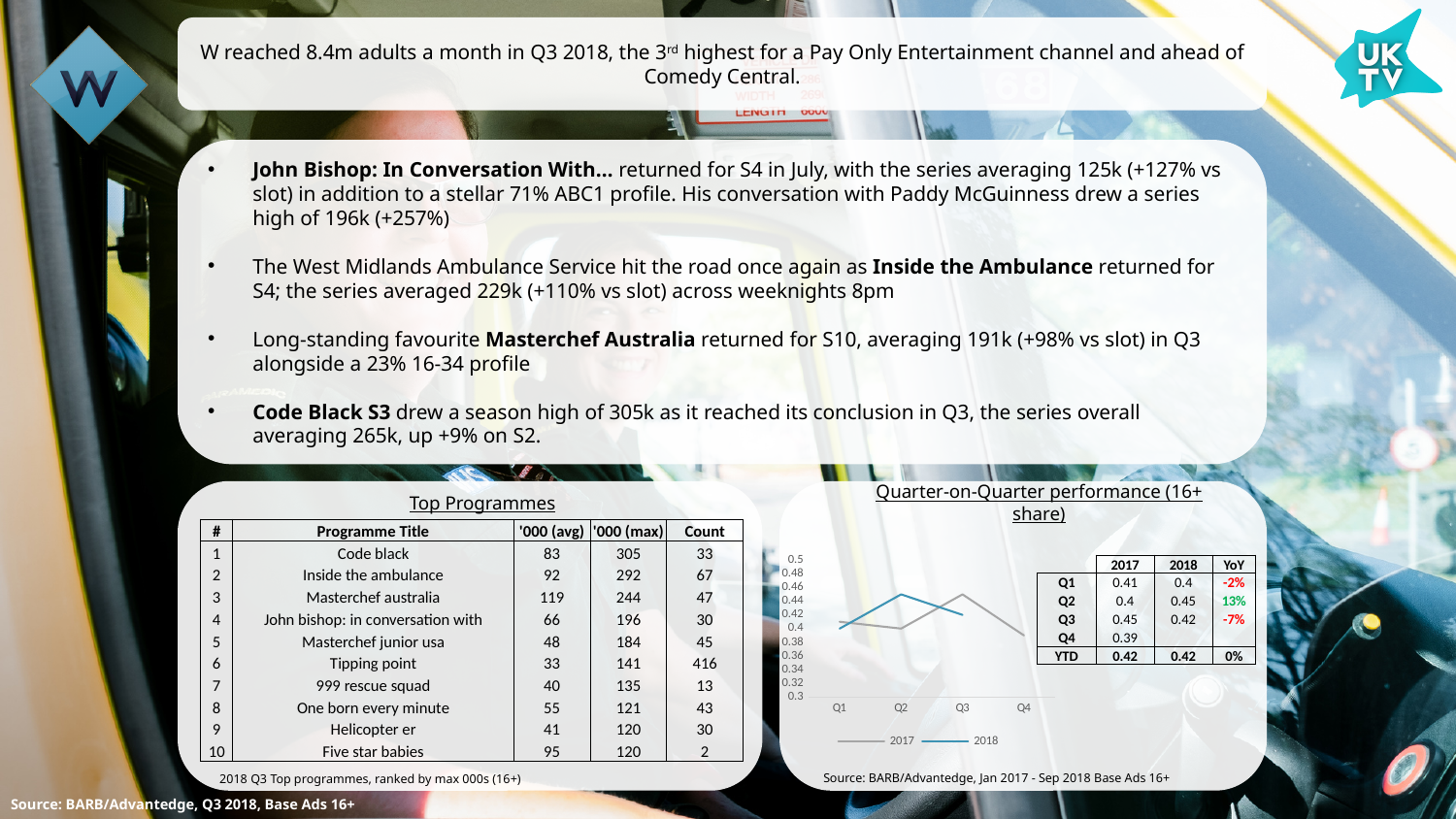
In the Quarter-on-Quarter performance chart, which quarter has the lowest 2017 value? Q4 What kind of chart is the Quarter-on-Quarter performance (16+ share) chart? line chart In the Quarter-on-Quarter performance chart, which is larger for Q2: the 2017 value or the 2018 value? 2018 In the Quarter-on-Quarter performance chart, what is the 2018 value for Q2? 0.45 In the Quarter-on-Quarter performance chart, which quarter has the highest 2017 value? Q3 How many quarters are shown on the x axis of the Quarter-on-Quarter performance chart? 4 In the Quarter-on-Quarter performance chart, what is the difference between the 2017 and 2018 values for Q3? 0.03 In the Quarter-on-Quarter performance chart, what is the 2017 value for Q4? 0.39 Which series are listed in the legend of the Quarter-on-Quarter performance chart? 2017 and 2018 In the Quarter-on-Quarter performance chart, is the 2017 value for Q4 greater or less than 0.4? less How many series does the legend of the Quarter-on-Quarter performance chart list? 2 In the Quarter-on-Quarter performance chart, what is the 2017 value for Q3? 0.45